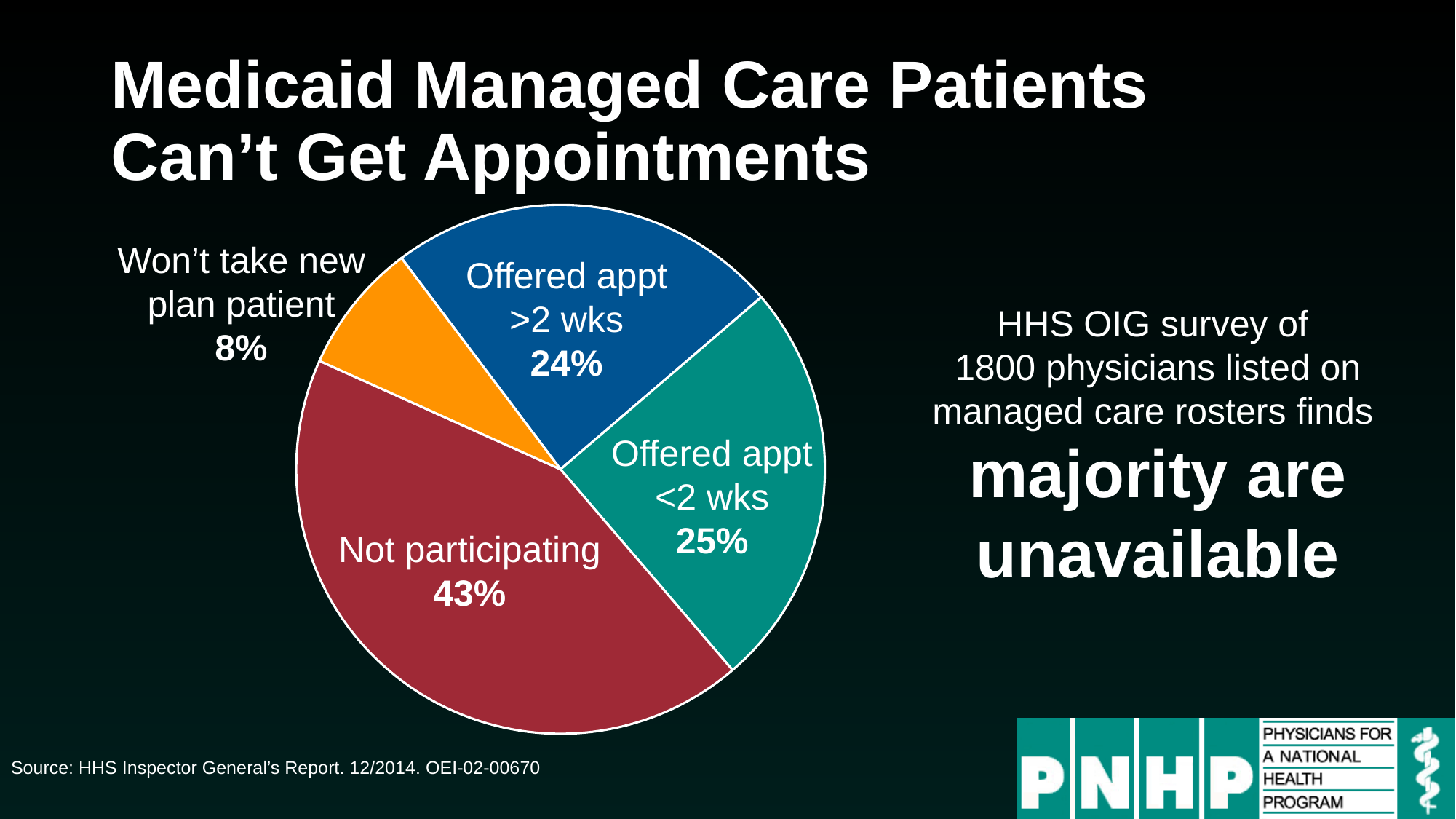
What colour is the 'Not participating' slice? red Which slice of the pie is the largest? Not participating What kind of chart is shown on the slide? pie chart What share of physicians are shown as 'Not participating'? 43% Which is larger: 'Offered appt <2 wks' or 'Won't take new plan patient'? Offered appt <2 wks What is the difference in percentage points between 'Not participating' and 'Offered appt <2 wks'? 18 How many slices does the pie chart have? 4 What is the combined share of 'Not participating' and 'Won't take new plan patient'? 51% What share of physicians won't take a new plan patient? 8% What percentage of physicians offered an appointment in more than 2 weeks? 24% What percentage of physicians offered an appointment in less than 2 weeks? 25% Which slice of the pie is the smallest? Won't take new plan patient